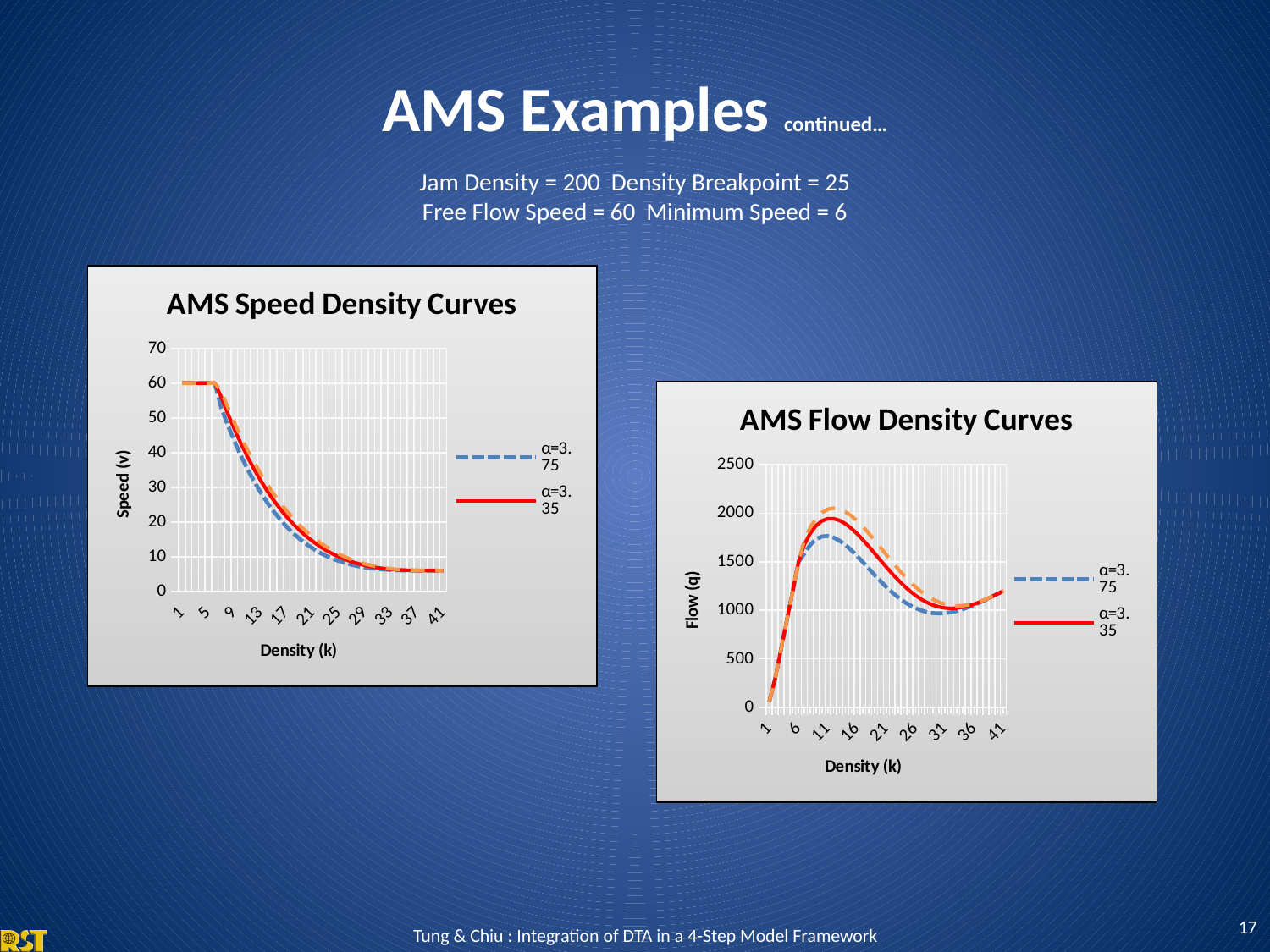
What kind of chart is the AMS Flow Density Curves chart? line chart In the AMS Speed Density Curves chart, how many series does the legend list? 2 In the AMS Speed Density Curves chart, is the speed for α=3.35 at density 9 greater or less than 40? greater In the AMS Flow Density Curves chart, at density 11, which series has the higher flow, α=3.35 or α=3.75? α=3.35 In the AMS Flow Density Curves chart, is the peak flow for α=3.75 greater or less than 2000? less In the AMS Flow Density Curves chart, is the flow at density 41 greater or less than 1000? greater In the AMS Speed Density Curves chart, do the speed values rise or fall as density increases along the x axis? fall What kind of chart is the AMS Speed Density Curves chart? line chart In the AMS Speed Density Curves chart, what is the speed at density 1? 60 What is the label of the x axis on the AMS Flow Density Curves chart? Density (k) In the AMS Flow Density Curves chart, what are the two legend entries? α=3.75 and α=3.35